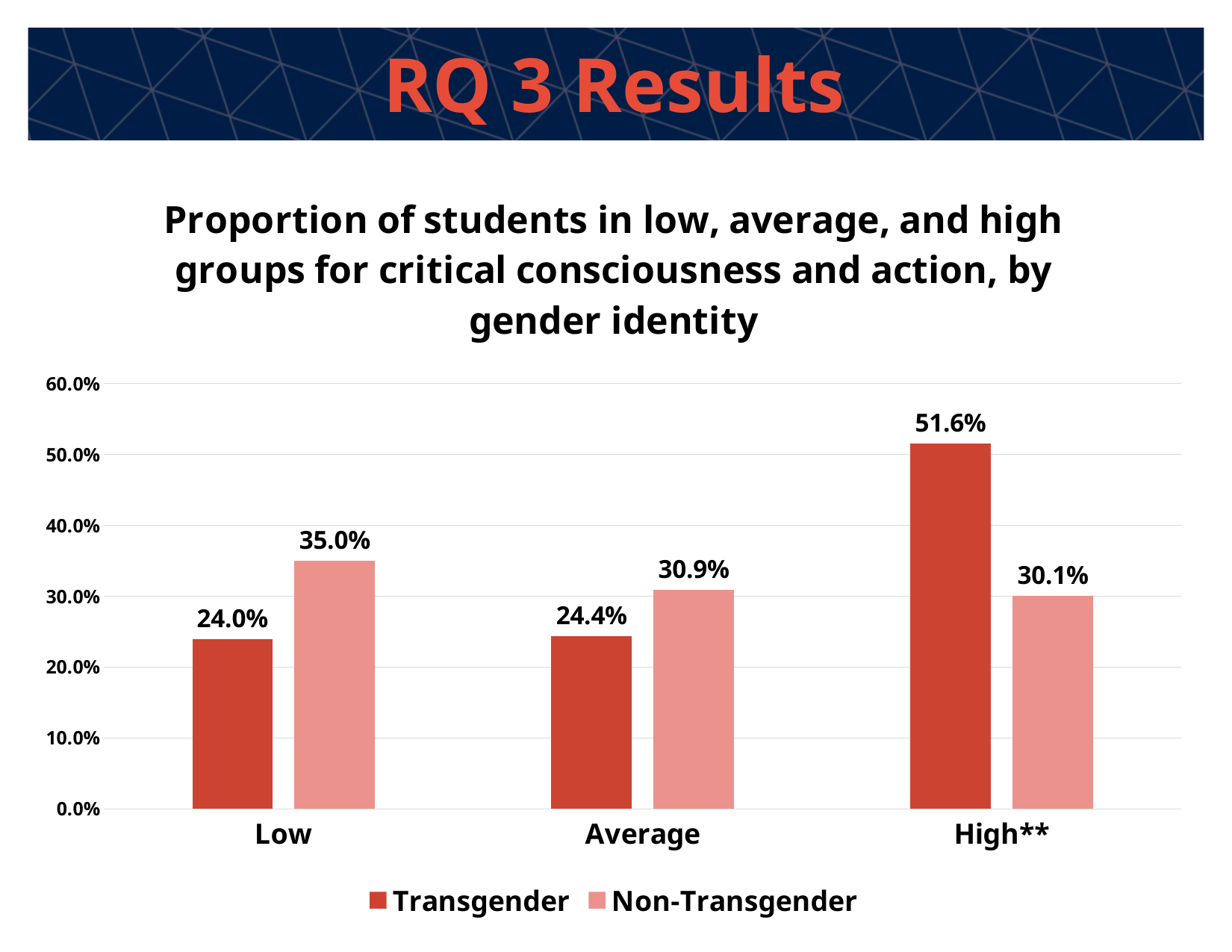
What is the difference between the Transgender and Non-Transgender values in the High** group? 21.5% What is the value for Transgender students in the Low group? 24.0% Is the value for Transgender students in the High** group greater or less than 50.0%? greater In the Average group, which series has the larger value, Transgender or Non-Transgender? Non-Transgender What kind of chart is shown on the slide? Bar chart How many groups are shown on the x axis? 3 How many series does the legend list? 2 Which group has the lowest value for the Non-Transgender series? High** What is the value for Non-Transgender students in the High** group? 30.1% What is the difference between the Non-Transgender and Transgender values in the Low group? 11.0% What is the value for Non-Transgender students in the Average group? 30.9% Which group has the highest value for the Transgender series? High**